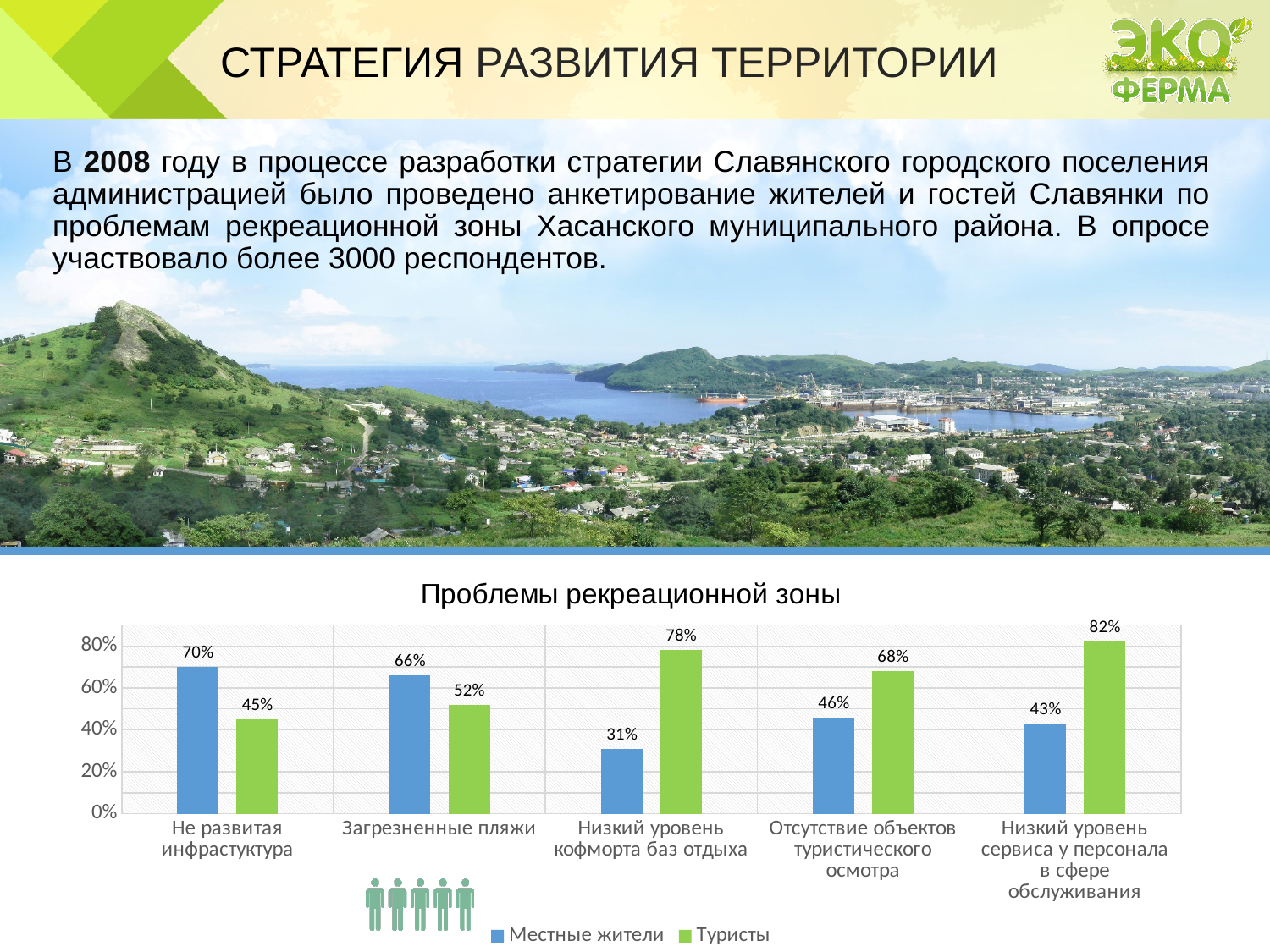
Which category has the highest value for Туристы? Низкий уровень сервиса у персонала в сфере обслуживания Which category has the lowest value for Местные жители? Низкий уровень кофморта баз отдыха Which is larger for Отсутствие объектов туристического осмотра: the value for Местные жители or for Туристы? Туристы How many series does the legend list? 2 What is the value for Туристы in the category Низкий уровень сервиса у персонала в сфере обслуживания? 82% What kind of chart is shown on the slide? Bar chart What is the difference between the Туристы and Местные жители values for Низкий уровень кофморта баз отдыха? 47% What is the value for Местные жители in the category Не развитая инфрастуктура? 70% What is the value for Туристы in the category Загрезненные пляжи? 52% Which colour represents the series Туристы in the chart? Green What is the title of the chart? Проблемы рекреационной зоны How many categories are shown on the x axis? 5